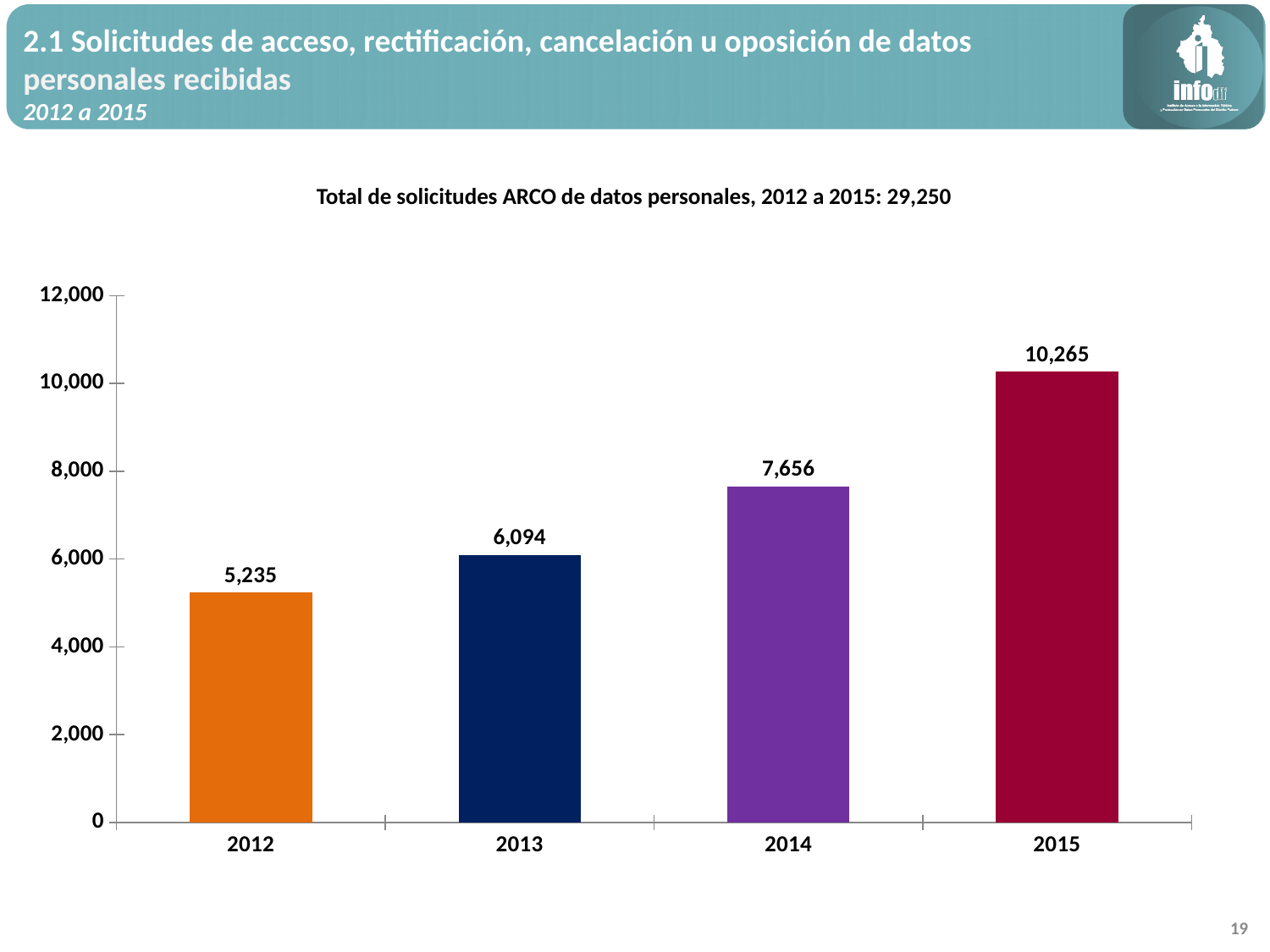
What is the difference between the values for 2015 and 2014? 2,609 What kind of chart is shown on the slide? bar chart What is the value for 2013? 6,094 Which year has the highest value? 2015 What is the value for 2012? 5,235 What is the value for 2014? 7,656 What is the difference between the values for 2013 and 2012? 859 Which is larger, the value for 2013 or the value for 2014? 2014 Do the values rise or fall from 2012 to 2015? rise Which year has the lowest value? 2012 How many years are shown on the x axis? 4 What is the value for 2015? 10,265